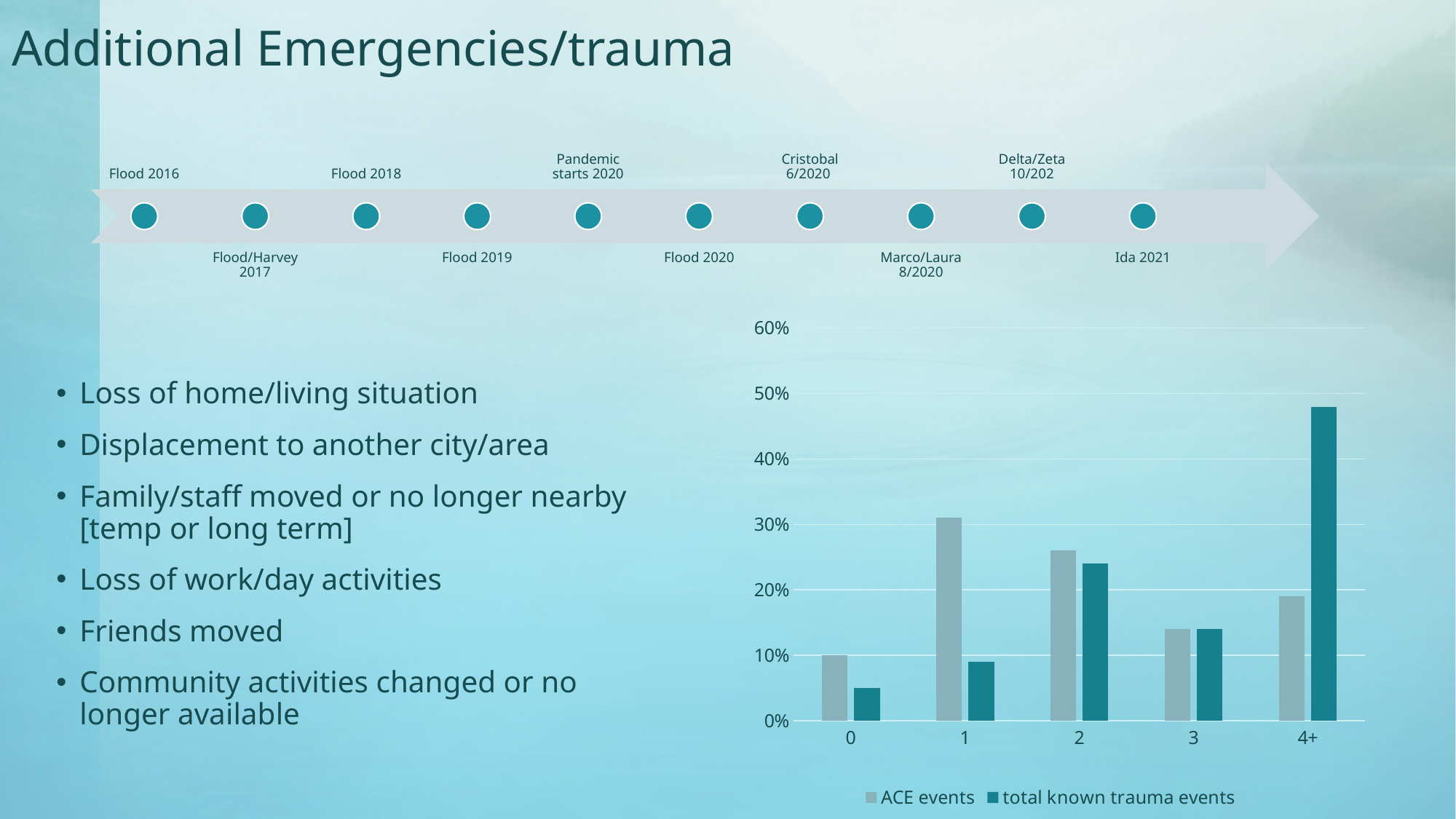
Which category has the highest value for ACE events? 1 Is the value for total known trauma events at 0 greater or less than 10%? less Which category has the lowest value for ACE events? 0 What are the two series listed in the legend of the bar chart? ACE events; total known trauma events For category 1, which series has the larger value, ACE events or total known trauma events? ACE events What kind of chart is shown on the slide? bar chart Which category has the lowest value for total known trauma events? 0 Which category has the highest value for total known trauma events? 4+ How many categories are shown on the x axis of the bar chart? 5 Is the value for total known trauma events at 4+ greater or less than 40%? greater Is the value for ACE events at 1 greater or less than 30%? greater How many series does the legend of the bar chart list? 2